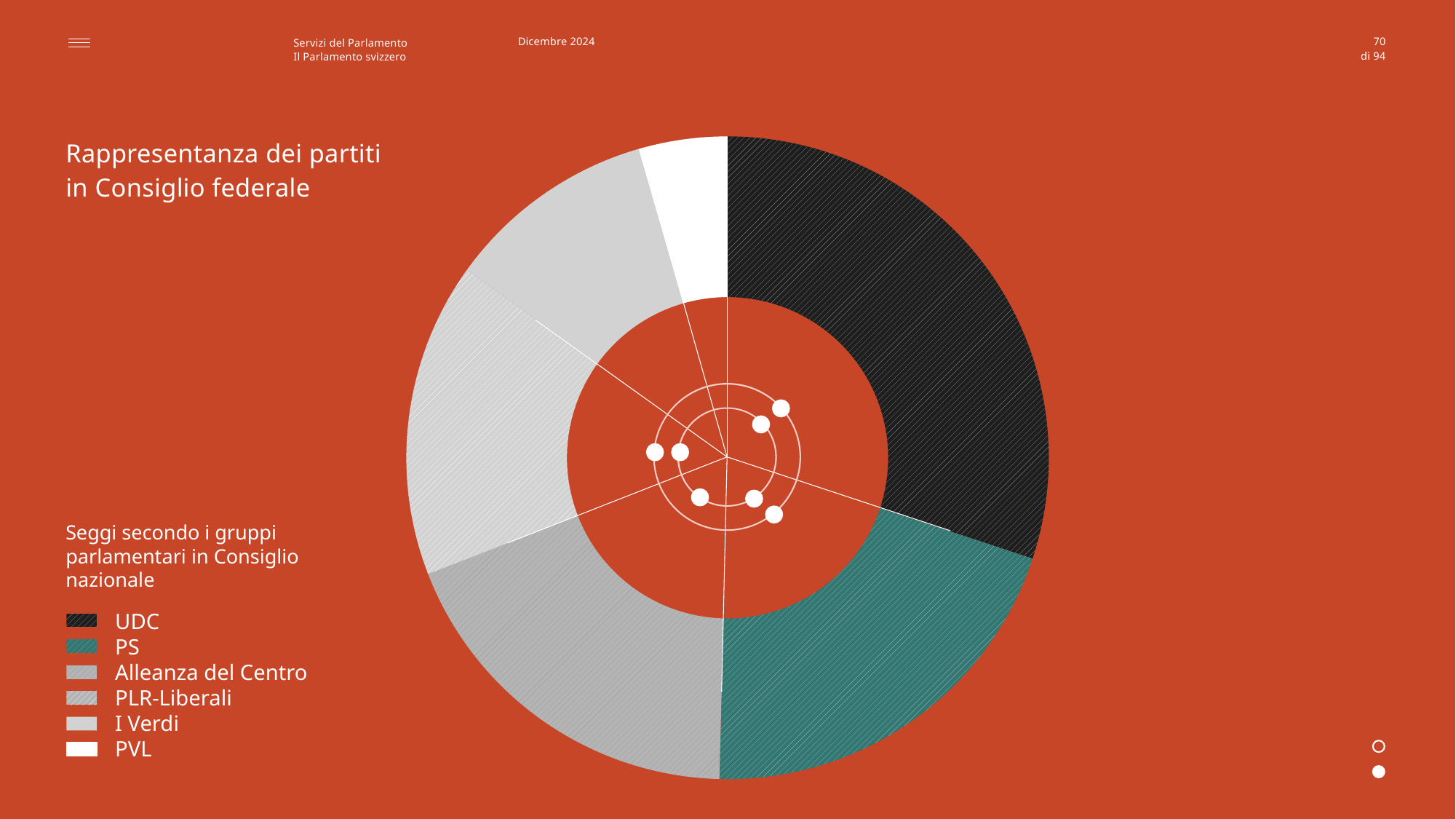
Which parliamentary group has the smallest slice of the chart? PVL What is the title of the chart on the slide? Rappresentanza dei partiti in Consiglio federale Which slice is larger, UDC or I Verdi? UDC Which legend entry is shown in teal/green? PS Which parliamentary group has the largest slice of the chart? UDC What kind of chart is shown on the slide? Pie chart (donut) Which slice is larger, UDC or PS? UDC How many parliamentary groups (categories) does the legend list? 6 Which slice is larger, PS or PVL? PS Which legend entry is shown with a solid white colour? PVL